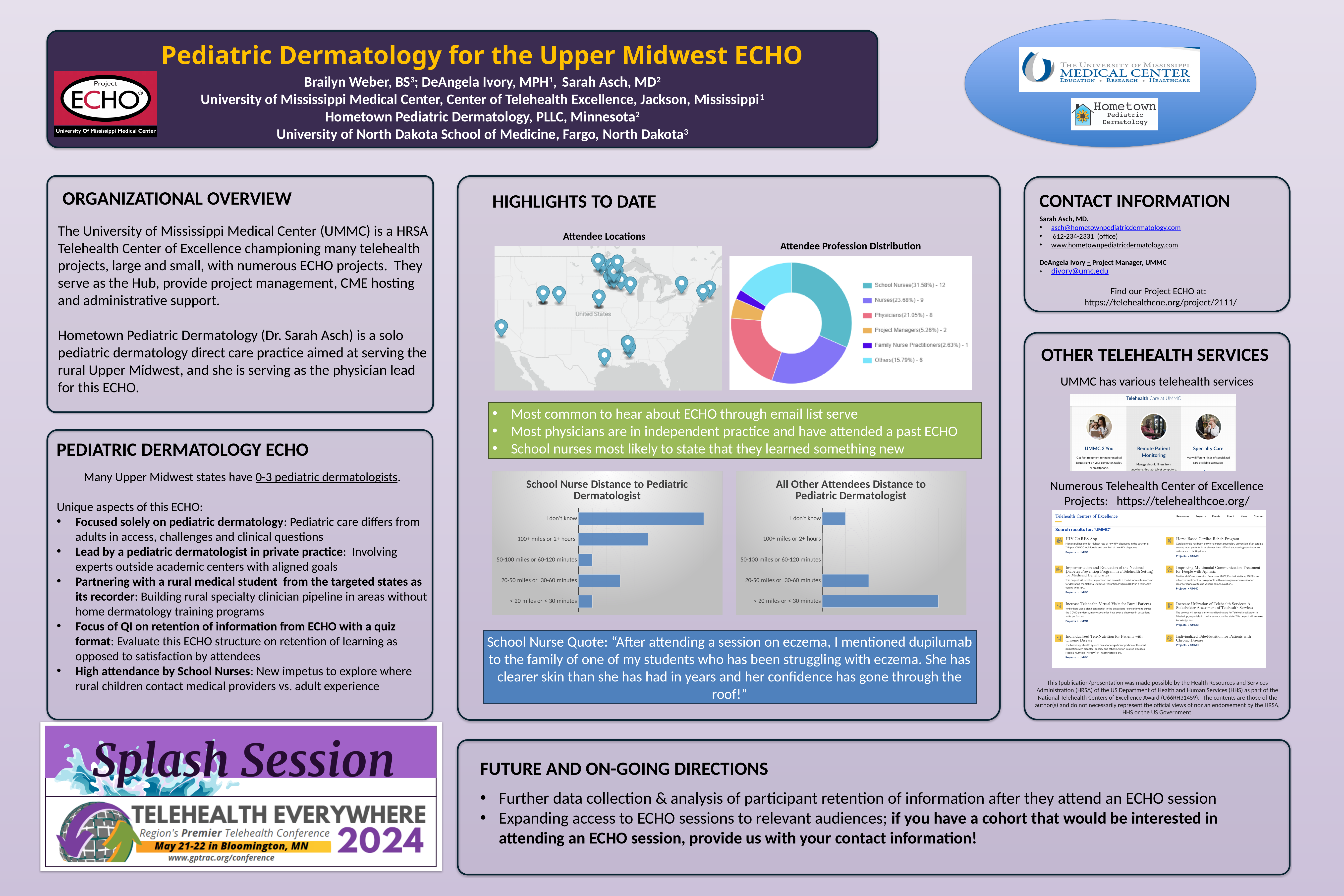
In the Attendee Profession Distribution chart, which profession has the largest share? School Nurses In the Attendee Profession Distribution chart, how many attendees are School Nurses? 12 In the All Other Attendees Distance to Pediatric Dermatologist chart, which category has the longest bar? < 20 miles or < 30 minutes In the Attendee Profession Distribution chart, what percentage of attendees are Physicians? 21.05% In the School Nurse Distance to Pediatric Dermatologist chart, which category has the longest bar? I don't know In the Attendee Profession Distribution chart, which group is larger: Physicians or Others? Physicians How many distance categories are shown in the All Other Attendees Distance to Pediatric Dermatologist chart? 5 In the Attendee Profession Distribution chart, how many more Nurses than Project Managers attended? 7 In the Attendee Profession Distribution chart, which profession has the smallest share? Family Nurse Practitioners What kind of chart is the Attendee Profession Distribution chart? Donut (pie) chart In the School Nurse Distance to Pediatric Dermatologist chart, which is larger: '100+ miles or 2+ hours' or '20-50 miles or 30-60 minutes'? 100+ miles or 2+ hours How many profession categories does the legend of the Attendee Profession Distribution chart list? 6